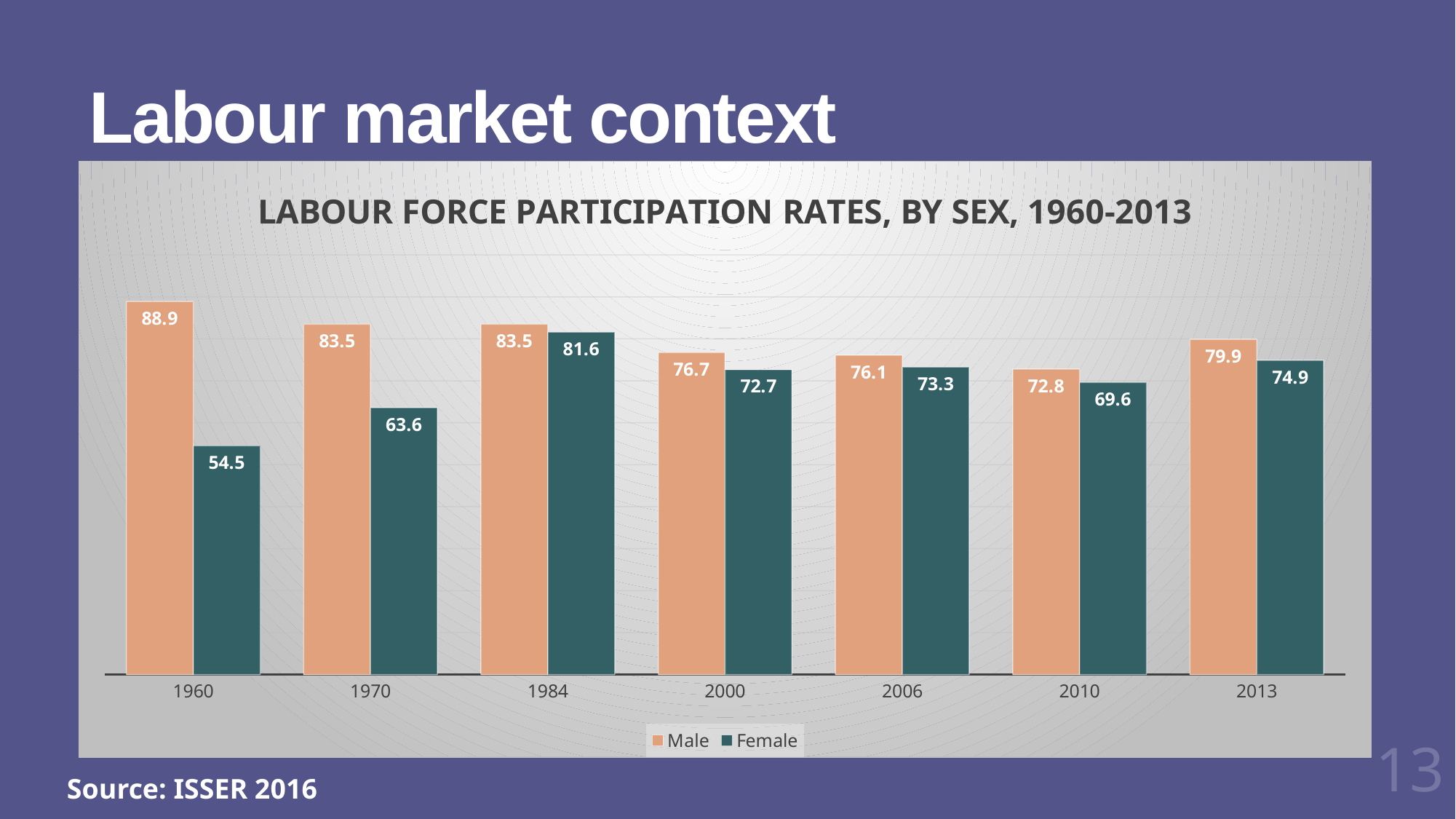
How many series does the legend list? 2 In which year is the Male participation rate highest? 1960 What is the title of the chart? LABOUR FORCE PARTICIPATION RATES, BY SEX, 1960-2013 Which is larger in 2006, the Male rate or the Female rate? Male In which year is the Female participation rate lowest? 1960 What is the Female labour force participation rate in 1984? 81.6 How many years are shown on the x axis? 7 What is the Male labour force participation rate in 1960? 88.9 What kind of chart is shown on the slide? Bar chart What is the difference between the Male and Female participation rates in 1960? 34.4 What is the difference between the Male and Female participation rates in 2013? 5.0 What is the Female labour force participation rate in 2010? 69.6